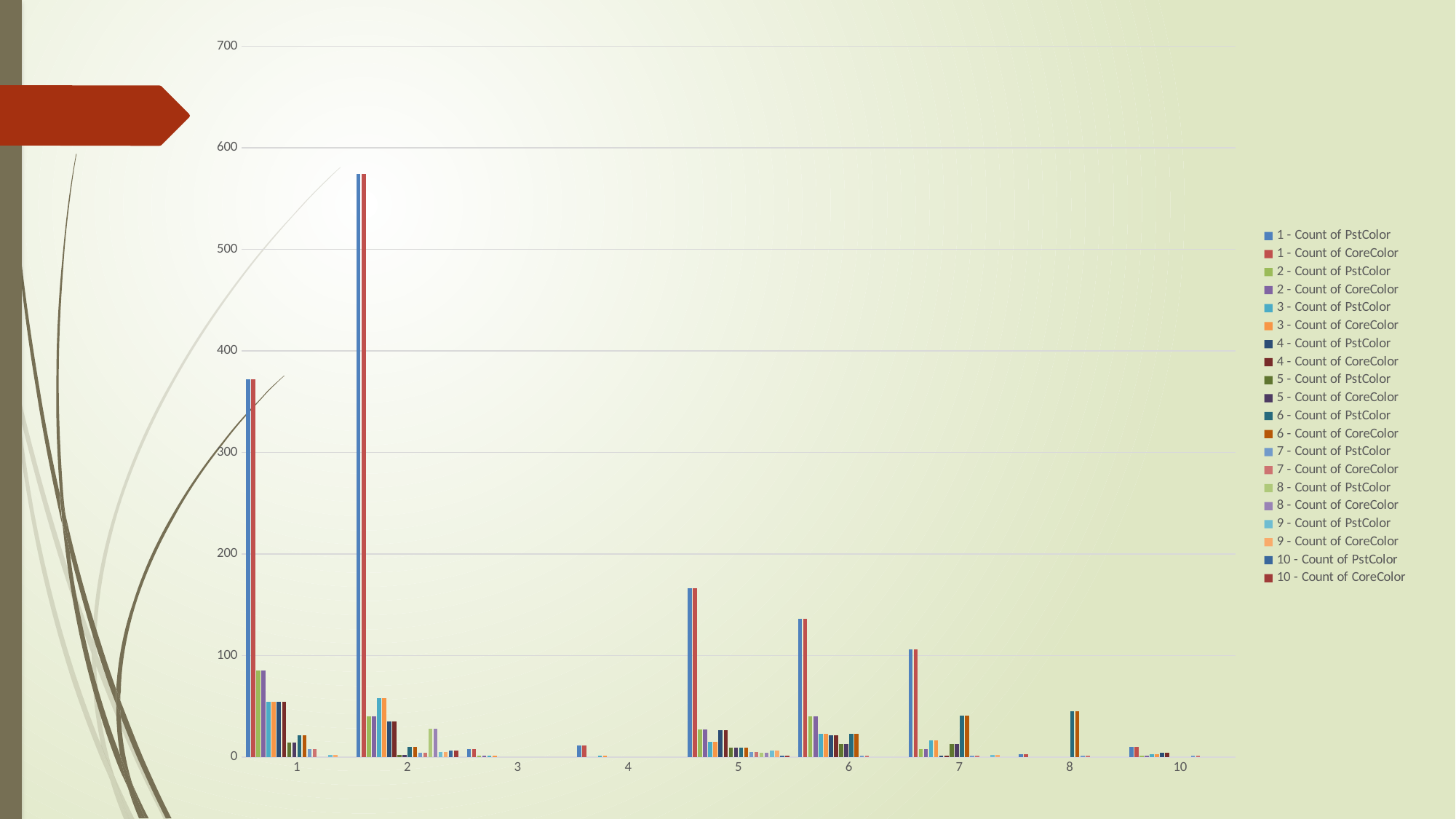
Is the value for "1 - Count of PstColor" at category 8 greater or less than 100? less What is the last series listed in the legend? 10 - Count of CoreColor Is the value for "1 - Count of PstColor" at category 1 greater or less than 300? greater Is the value for "1 - Count of CoreColor" at category 5 greater or less than 100? greater Which category has the larger value for "1 - Count of CoreColor", category 5 or category 6? category 5 Which category has the larger value for "1 - Count of PstColor", category 1 or category 2? category 2 What is the first series listed in the legend? 1 - Count of PstColor What kind of chart is shown on the slide? bar chart Which x-axis category contains the tallest bar in the chart? 2 How many series does the legend list? 20 How many categories are shown on the x axis? 9